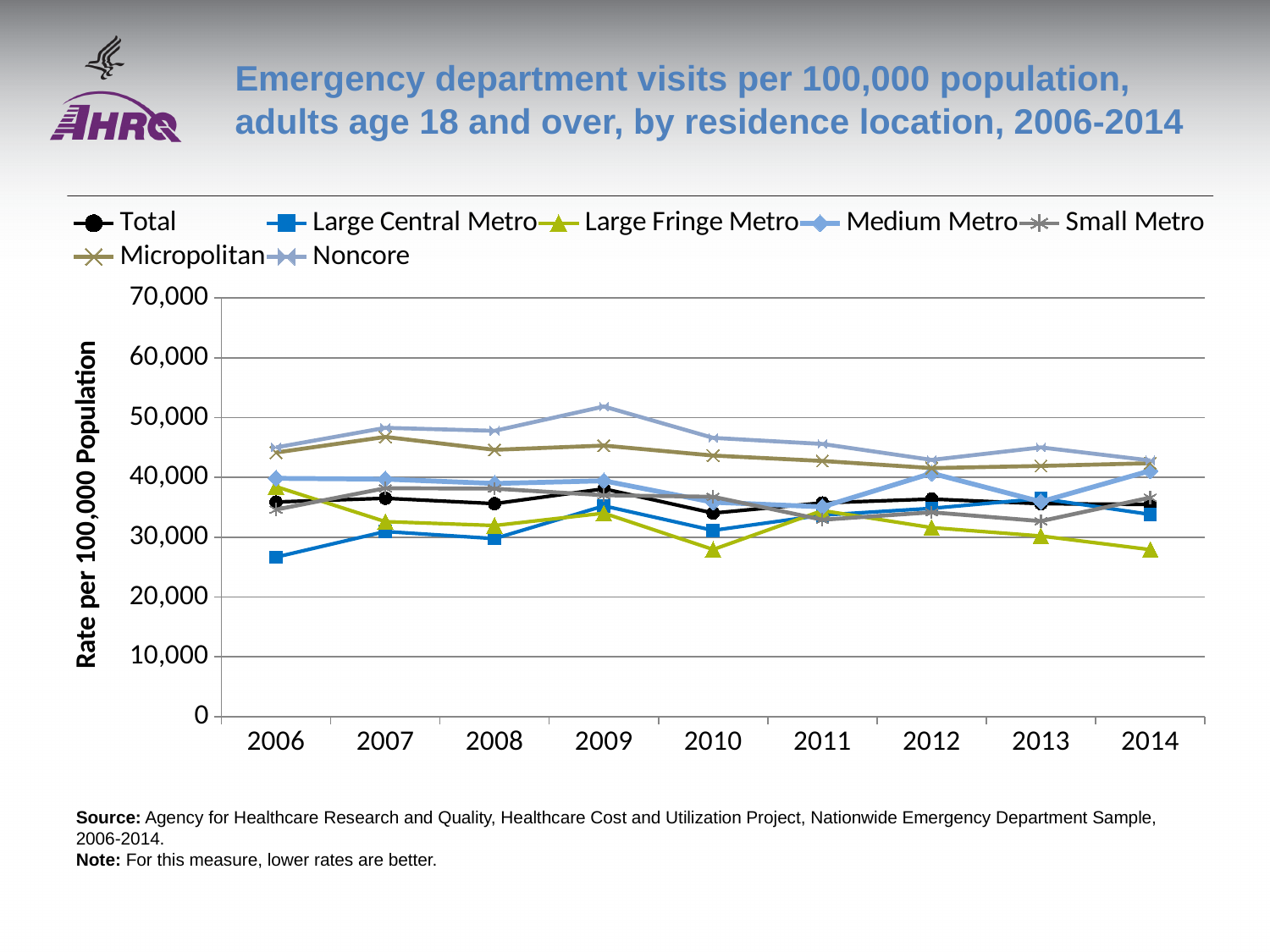
Which residence location has the highest rate in 2009? Noncore Does the rate for Large Fringe Metro rise or fall from 2006 to 2014? fall Is the value for Noncore in 2009 greater or less than 50,000? greater What kind of chart is shown on the slide? line chart What is the title of the y axis? Rate per 100,000 Population How many series does the legend list? 7 Is the value for Large Central Metro in 2006 greater or less than 30,000? less Which residence location has the lowest rate in 2006? Large Central Metro How many years are plotted along the x axis? 9 In which year does the Noncore series reach its highest value? 2009 In 2014, which is larger: the rate for Large Central Metro or the rate for Large Fringe Metro? Large Central Metro Is the value for Micropolitan in 2007 greater or less than 40,000? greater